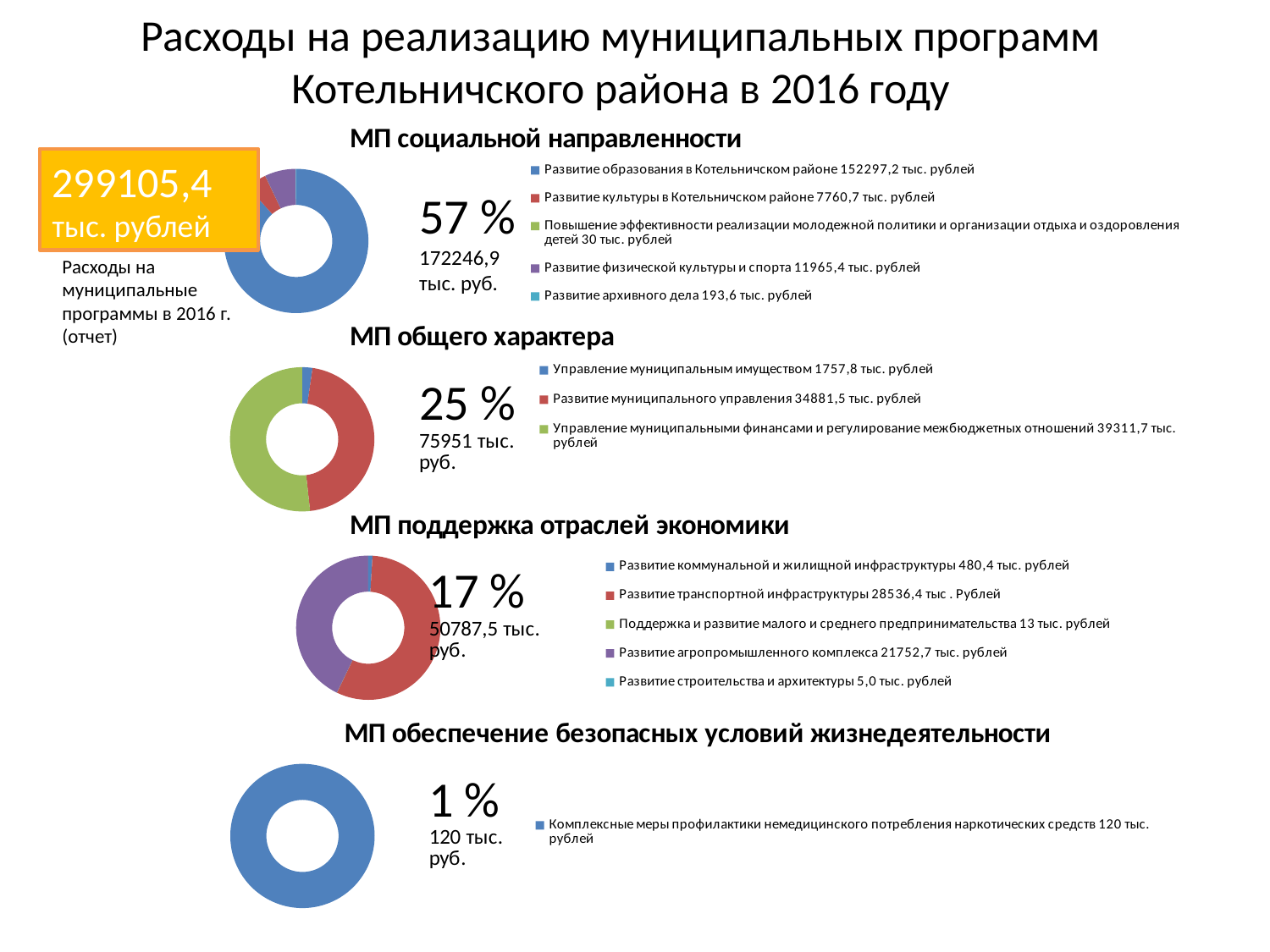
What is the total amount of spending on municipal programmes in 2016 shown in the orange box? 299105,4 тыс. рублей In the "МП поддержка отраслей экономики" chart, what is the value for "Развитие строительства и архитектуры"? 5,0 тыс. рублей In the "МП социальной направленности" chart, what is the value for "Развитие образования в Котельничском районе"? 152297,2 тыс. рублей In the "МП общего характера" chart, what is the difference between "Управление муниципальными финансами и регулирование межбюджетных отношений" and "Развитие муниципального управления"? 4430,2 тыс. рублей In the "МП социальной направленности" chart, how many categories does the legend list? 5 In the "МП социальной направленности" chart, which category has the smallest value? Повышение эффективности реализации молодежной политики и организации отдыха и оздоровления детей What share of total municipal programme spending does "МП социальной направленности" represent? 57 % What is the total spending shown for "МП общего характера"? 75951 тыс. руб. In the "МП поддержка отраслей экономики" chart, which is larger: "Развитие транспортной инфраструктуры" or "Развитие агропромышленного комплекса"? Развитие транспортной инфраструктуры How many categories does the legend of the "МП обеспечение безопасных условий жизнедеятельности" chart list? 1 What kind of chart is used for "МП социальной направленности"? Doughnut (pie) chart In the "МП общего характера" chart, which category has the largest value? Управление муниципальными финансами и регулирование межбюджетных отношений